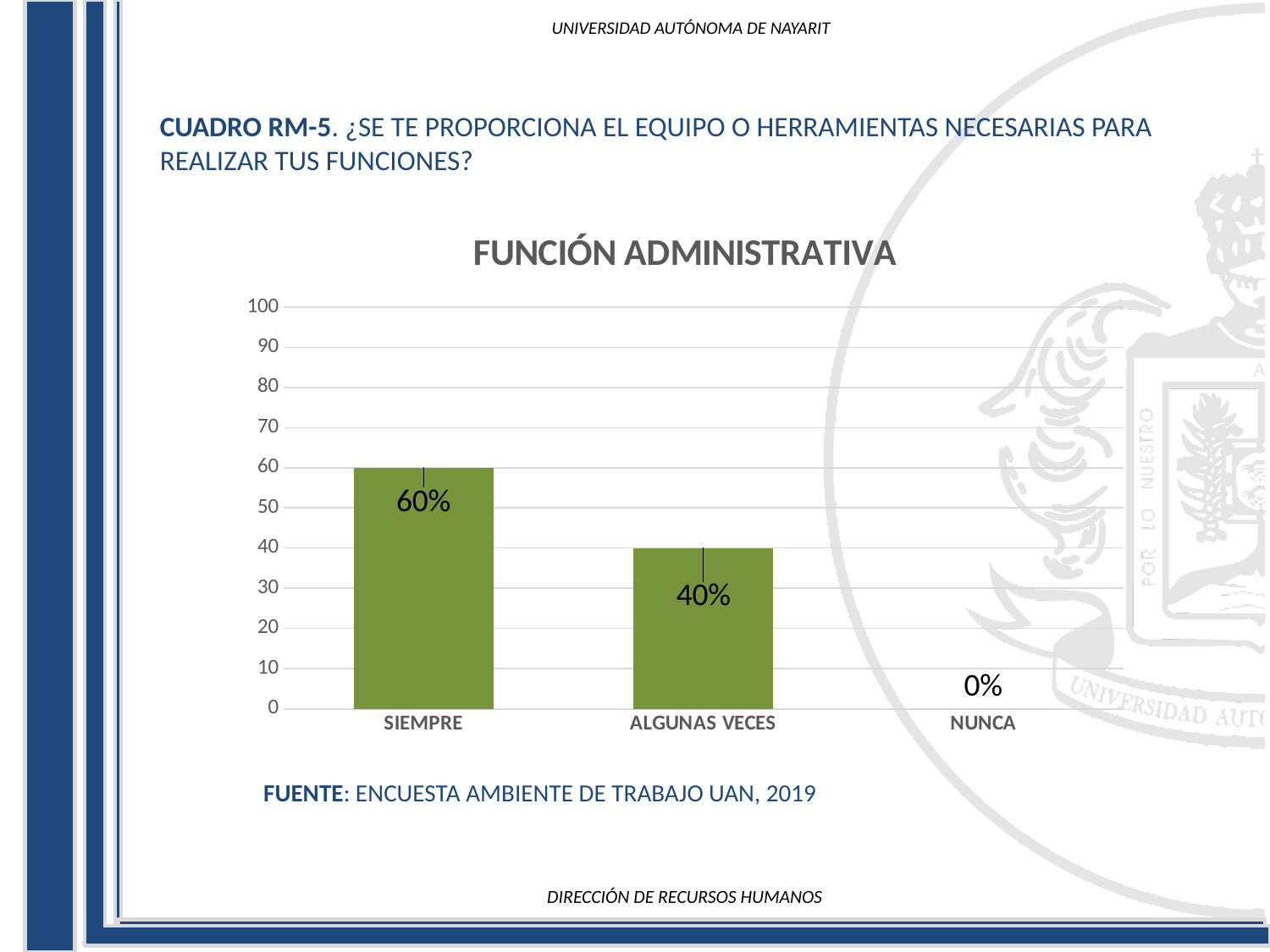
Which category has the highest value? SIEMPRE What kind of chart is shown on the slide? bar chart How many categories are shown on the x axis? 3 Do the values rise or fall from left to right along the x axis? fall What is the difference between the values for SIEMPRE and ALGUNAS VECES? 20% What is the value for SIEMPRE? 60% What is the value for ALGUNAS VECES? 40% What is the title of the chart? FUNCIÓN ADMINISTRATIVA Is the value for ALGUNAS VECES greater or less than 50? less Which is larger, the value for SIEMPRE or the value for ALGUNAS VECES? SIEMPRE What is the value for NUNCA? 0% Which category has the lowest value? NUNCA